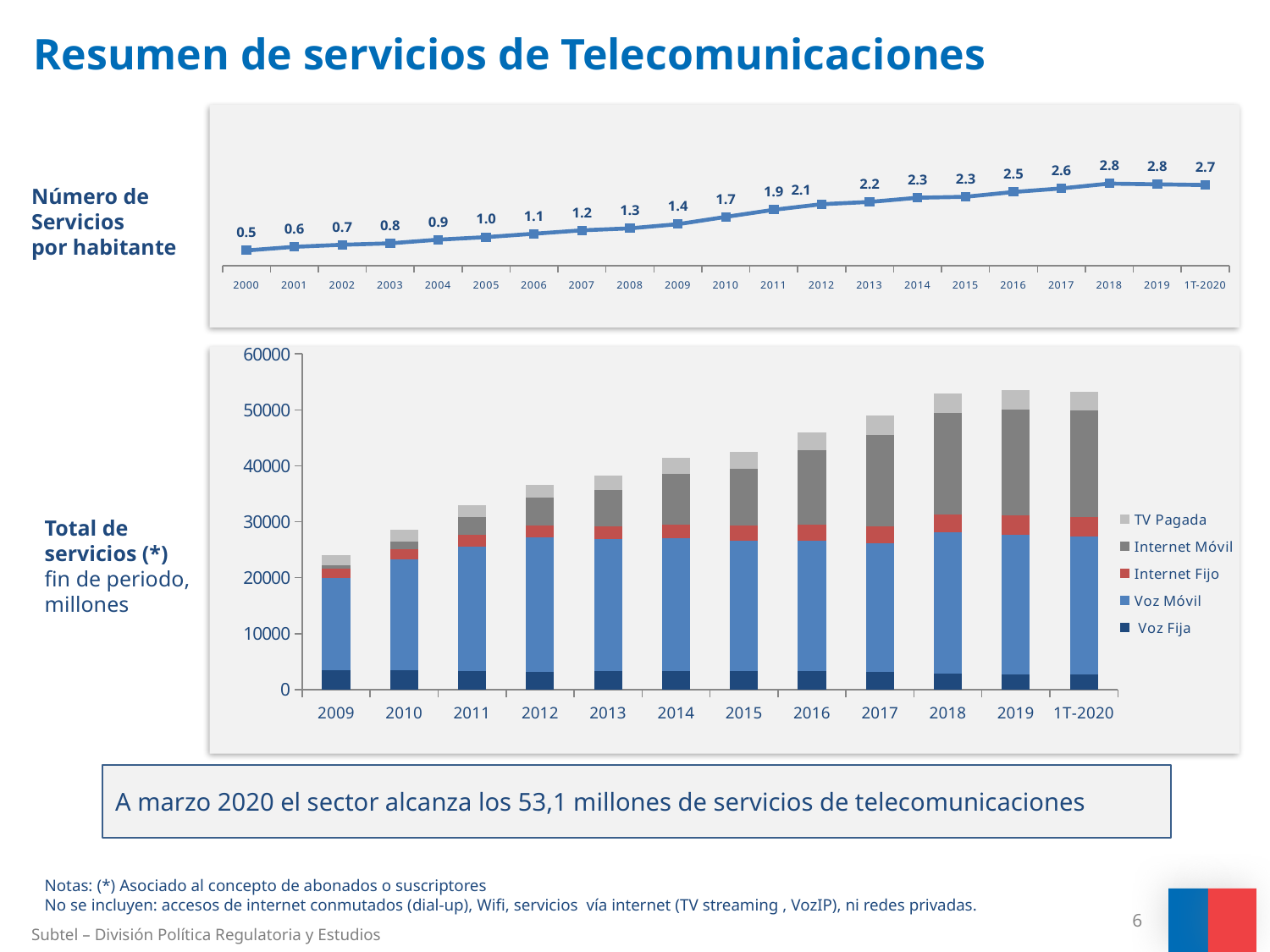
In the bottom chart 'Total de servicios', is the total stacked value for 2009 greater or less than 30000? less In the top chart 'Número de Servicios por habitante', which year has the lowest value? 2000 In the top chart 'Número de Servicios por habitante', which is larger, the value for 2010 or the value for 2012? 2012 In the bottom chart 'Total de servicios', how many periods are shown on the x axis? 12 In the top chart 'Número de Servicios por habitante', what is the value for 1T-2020? 2.7 In the top chart 'Número de Servicios por habitante', what is the difference between the values for 2019 and 2000? 2.3 What kind of chart is the bottom chart 'Total de servicios'? Stacked bar chart In the top chart 'Número de Servicios por habitante', what is the value for 2010? 1.7 In the bottom chart 'Total de servicios', is the total stacked value for 2019 greater or less than 50000? greater What kind of chart is the top chart 'Número de Servicios por habitante'? Line chart In the top chart 'Número de Servicios por habitante', how many data points are plotted? 21 In the bottom chart 'Total de servicios', how many series does the legend list? 5